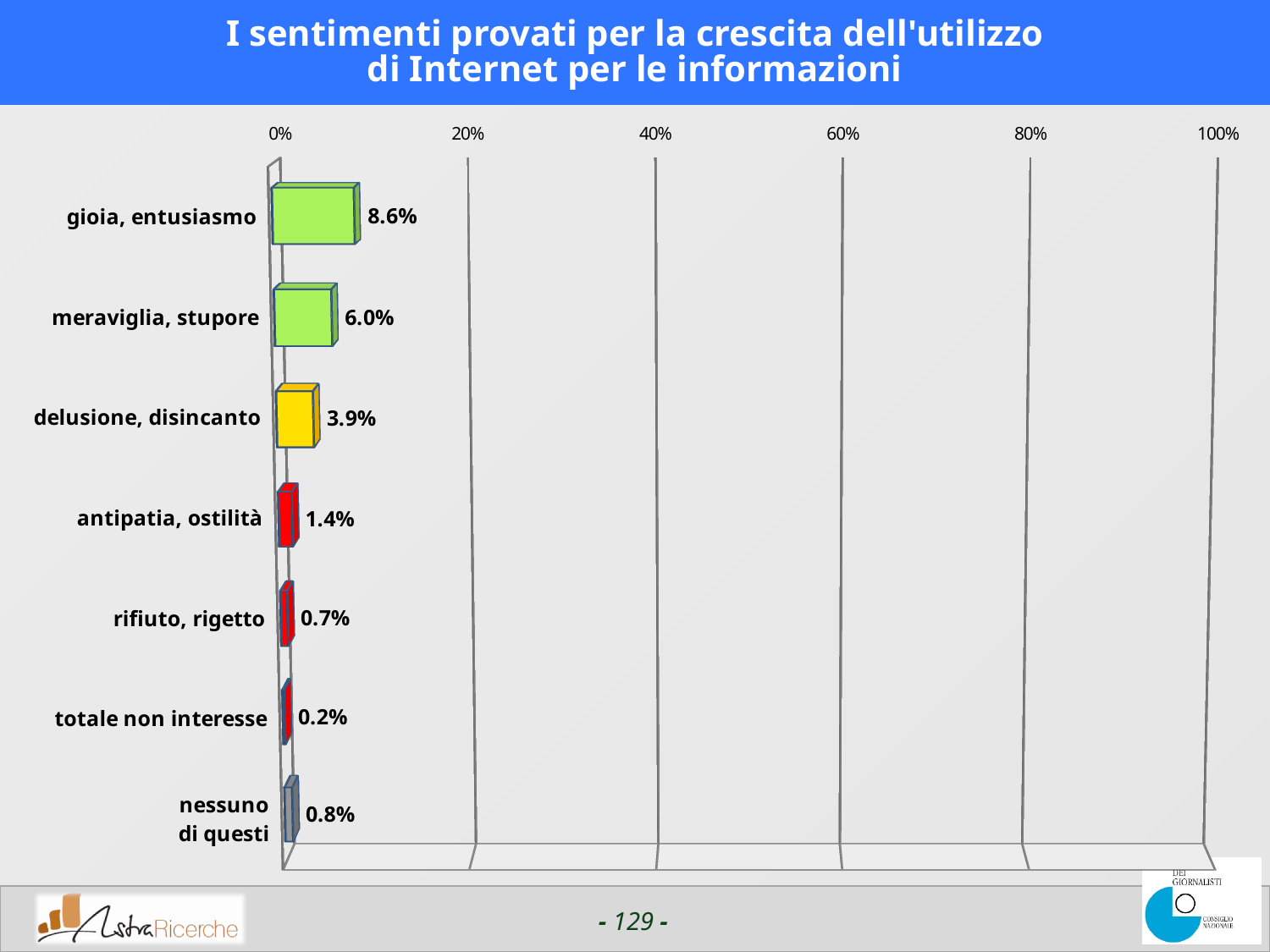
Which is larger, the value for "rifiuto, rigetto" or the value for "nessuno di questi"? nessuno di questi Which category has the highest value? gioia, entusiasmo What kind of chart is shown on the slide? bar chart What is the difference between the values for "antipatia, ostilità" and "rifiuto, rigetto"? 0.7% What is the value for "nessuno di questi"? 0.8% What is the value for "delusione, disincanto"? 3.9% What is the value for "totale non interesse"? 0.2% Which category has the lowest value? totale non interesse Is the value for "gioia, entusiasmo" greater or less than 20%? less What is the value for "gioia, entusiasmo"? 8.6% What is the difference between the values for "gioia, entusiasmo" and "meraviglia, stupore"? 2.6% How many categories are shown in the chart? 7